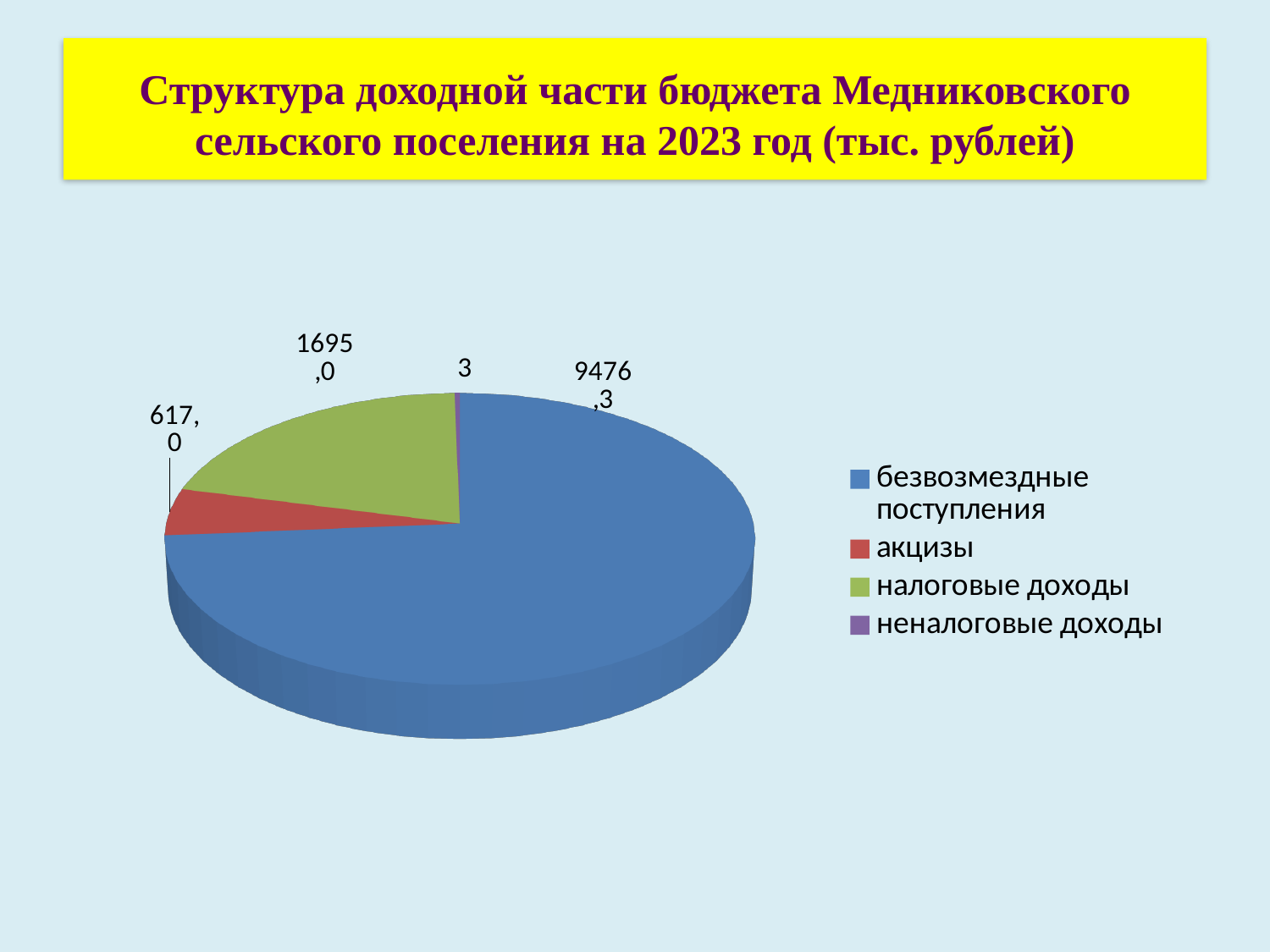
What is the difference between the values for безвозмездные поступления and налоговые доходы? 7781,3 What is the value for акцизы? 617,0 What is the value for безвозмездные поступления? 9476,3 What colour is the slice for акцизы? red What is the value for налоговые доходы? 1695,0 What is the value for неналоговые доходы? 3 How many categories does the legend list? 4 Which category has the smallest slice of the pie? неналоговые доходы Which category has the largest slice of the pie? безвозмездные поступления What is the difference between the values for налоговые доходы and акцизы? 1078,0 Which is larger, the value for акцизы or the value for налоговые доходы? налоговые доходы What kind of chart is shown on the slide? pie chart